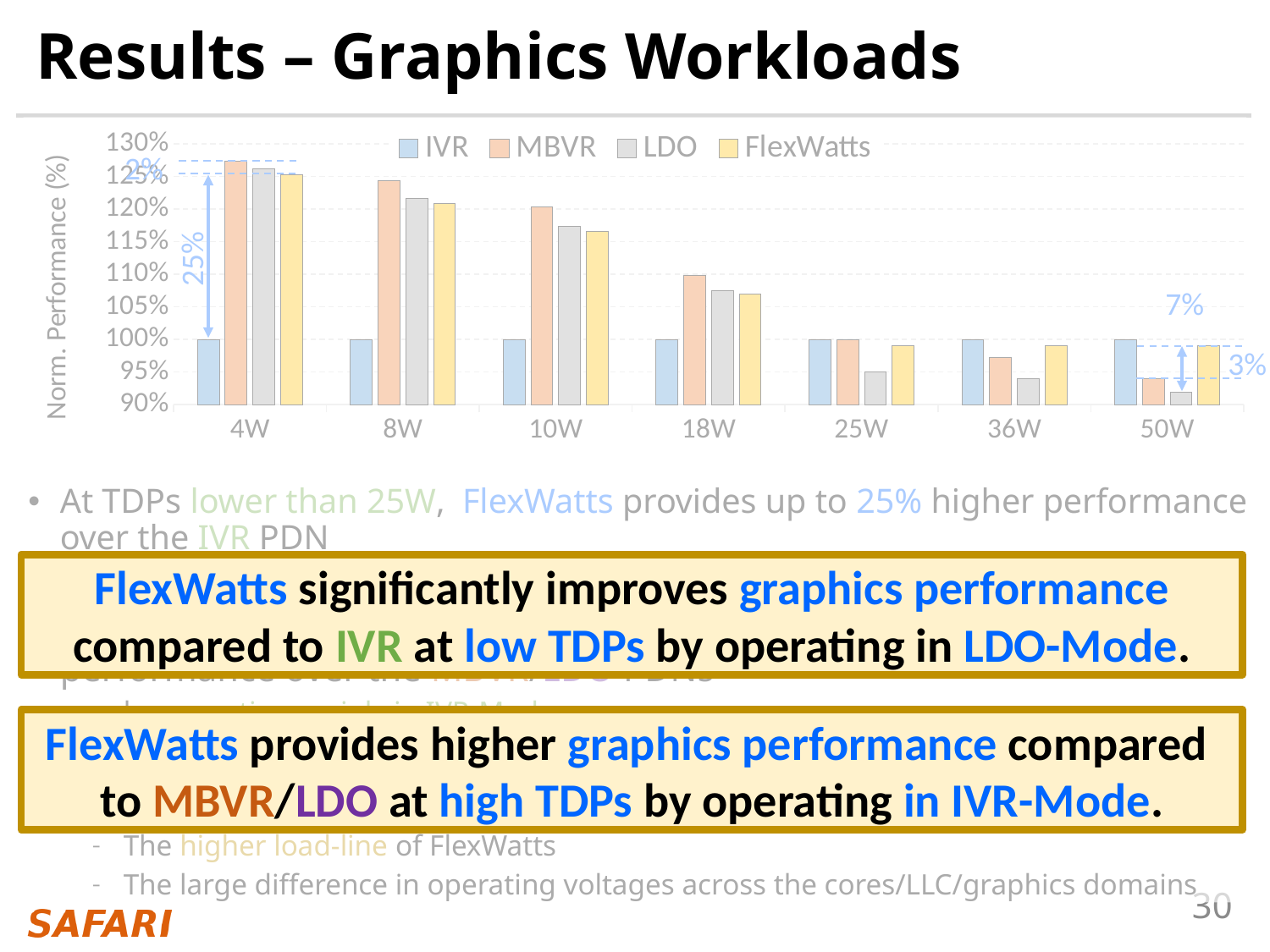
What is the y-axis title of the chart? Norm. Performance (%) Do the MBVR values rise or fall as TDP increases along the x axis? fall How many series does the legend list? 4 Is the value for MBVR at 4W greater or less than 120%? greater How many TDP categories are shown on the x axis? 7 Is the value for LDO at 50W greater or less than 95%? less Is the value for FlexWatts at 18W greater or less than 105%? greater What kind of chart is shown on the slide? bar chart What is the normalized performance of IVR at 4W? 100% At which TDP is the MBVR bar the highest? 4W What is the normalized performance of IVR at 50W? 100% At 50W, which is larger: FlexWatts or LDO? FlexWatts